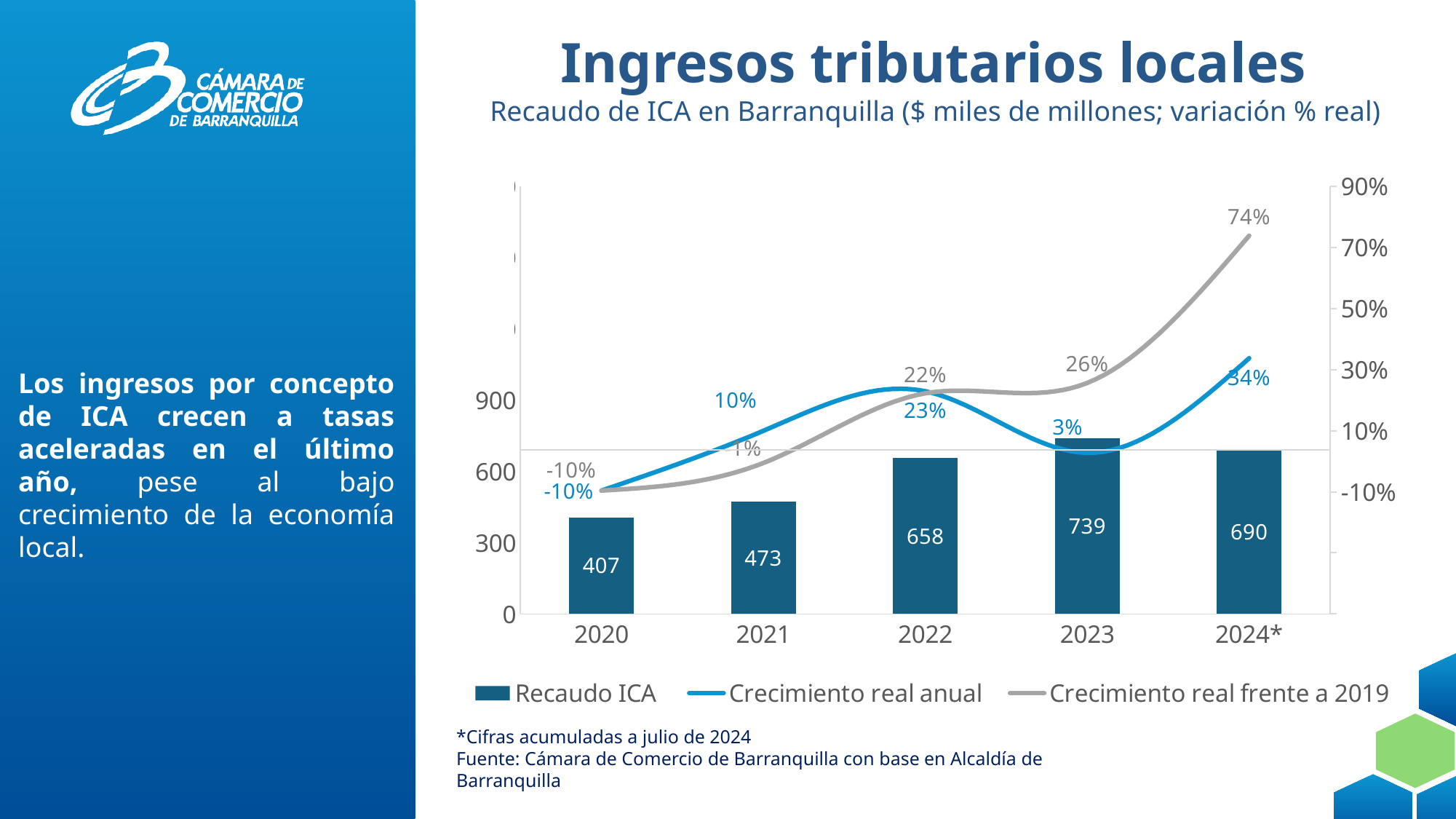
How many series does the legend list? 3 What is the Crecimiento real frente a 2019 value for 2024*? 74% What is the title of the chart? Ingresos tributarios locales Which year has the highest Recaudo ICA bar? 2023 What is the Crecimiento real anual value for 2023? 3% How many years are shown on the x axis? 5 Which year has the lowest Recaudo ICA bar? 2020 What is the difference between the Recaudo ICA values for 2023 and 2020? 332 What is the Recaudo ICA value for 2022? 658 What kind of chart is this? Combined bar and line chart Does the Crecimiento real frente a 2019 line rise or fall from 2020 to 2024*? Rises Which is larger, the Recaudo ICA value for 2022 or for 2024*? 2024*